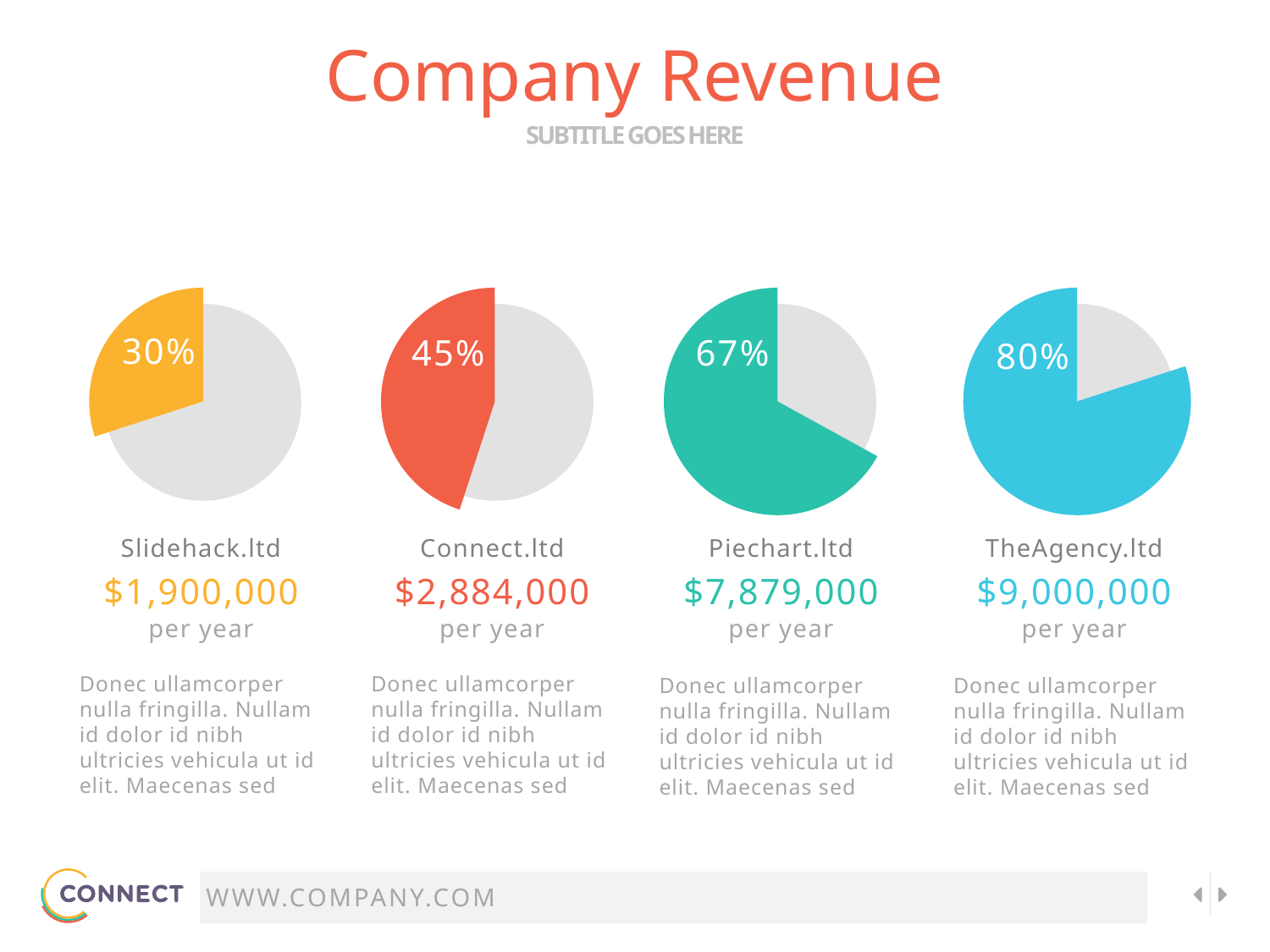
Which pie chart shows a larger percentage, Connect.ltd or Piechart.ltd? Piechart.ltd Which company's pie chart shows the highest percentage? TheAgency.ltd In the Slidehack.ltd pie chart, what percentage is shown on the coloured slice? 30% What revenue per year is shown under the Piechart.ltd pie chart? $7,879,000 What colour is the highlighted slice in the Connect.ltd pie chart? Red What is the difference between the percentage in the TheAgency.ltd pie chart and the percentage in the Slidehack.ltd pie chart? 50% In the TheAgency.ltd pie chart, what percentage is shown on the coloured slice? 80% In the Connect.ltd pie chart, what percentage is shown on the coloured slice? 45% In the Piechart.ltd pie chart, what percentage is shown on the coloured slice? 67% How many pie charts are on the slide? 4 Which company's pie chart shows the lowest percentage? Slidehack.ltd What kind of charts are shown on the slide? Pie charts